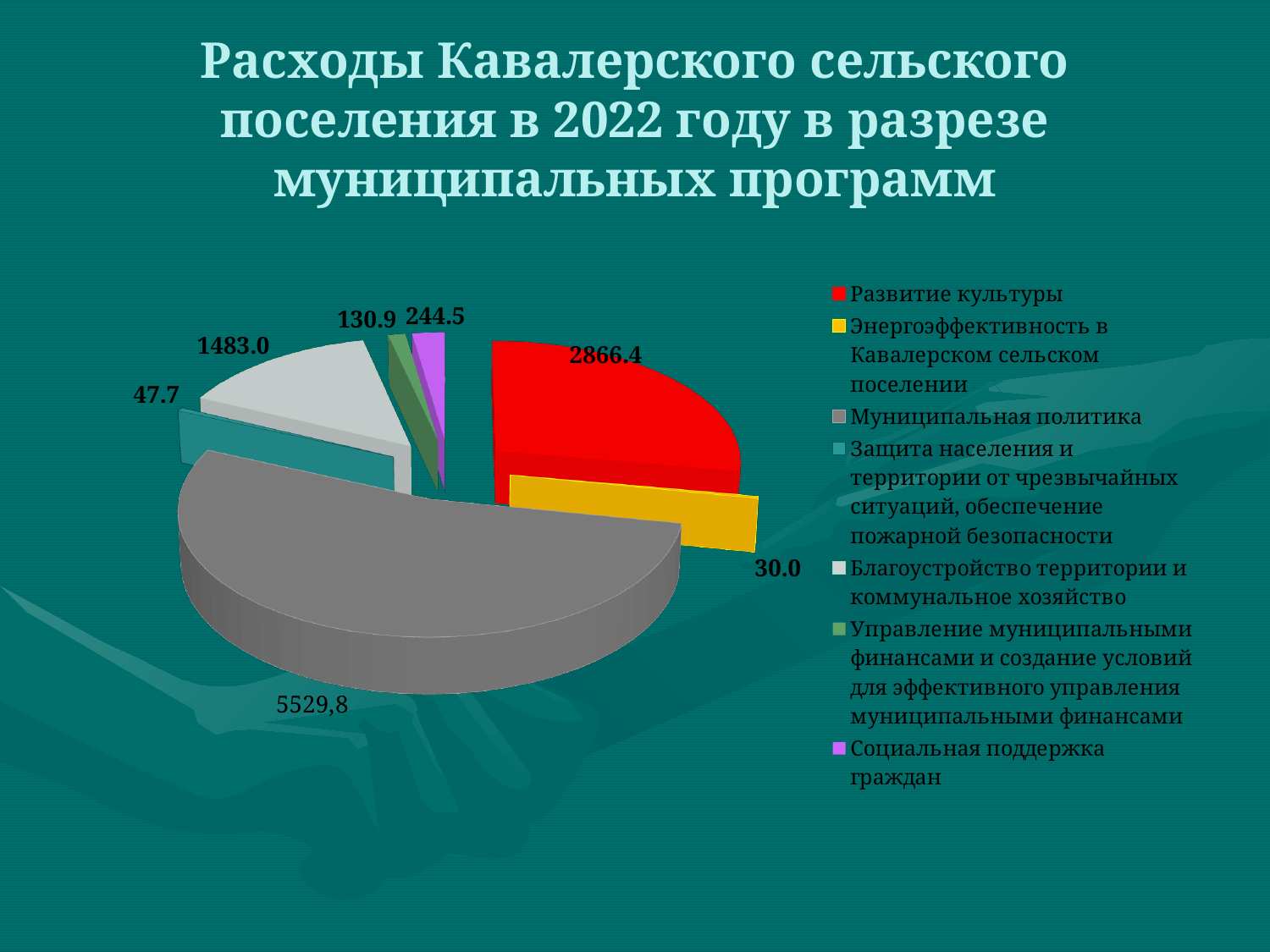
Which category has the smallest slice of the pie? Энергоэффективность в Кавалерском сельском поселении What is the value for Социальная поддержка граждан? 244.5 What colour is the slice for Развитие культуры? red What is the value for Муниципальная политика? 5529,8 What is the value for Энергоэффективность в Кавалерском сельском поселении? 30.0 What is the value for Развитие культуры? 2866.4 What is the value for Благоустройство территории и коммунальное хозяйство? 1483.0 How many slices does the pie chart have? 7 What type of chart is shown on the slide? pie chart Which is larger: Социальная поддержка граждан or Управление муниципальными финансами и создание условий для эффективного управления муниципальными финансами? Социальная поддержка граждан Which category has the largest slice of the pie? Муниципальная политика What is the difference between the values for Развитие культуры and Благоустройство территории и коммунальное хозяйство? 1383.4